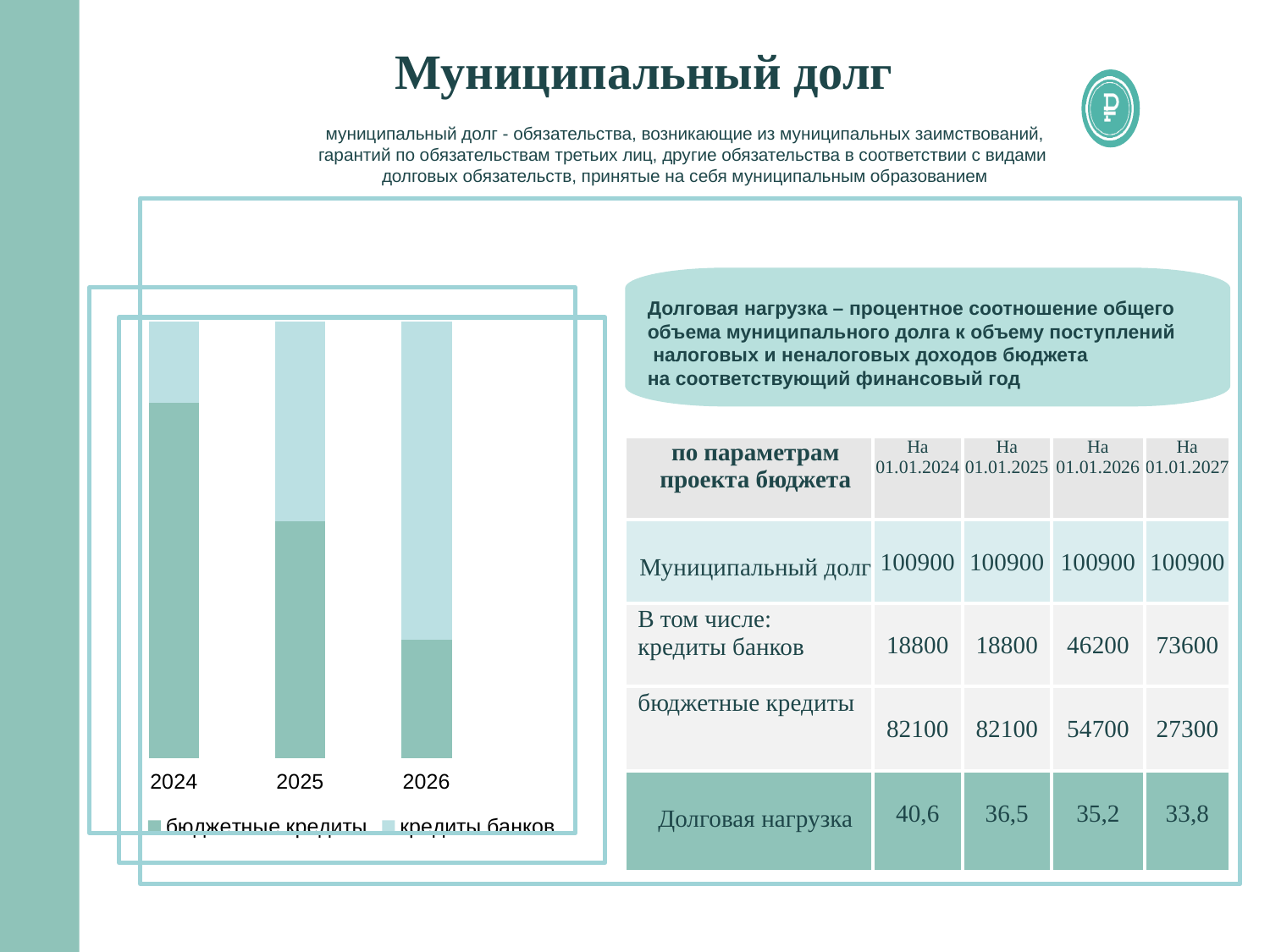
What kind of chart is shown on the left of the slide? bar chart In the 2024 bar, which segment is larger: бюджетные кредиты or кредиты банков? бюджетные кредиты Does the кредиты банков segment rise or fall from 2024 to 2026 in the bar chart? rise In the 2026 bar, which segment is larger: бюджетные кредиты or кредиты банков? кредиты банков How many series does the legend of the bar chart list? 2 In which year is the кредиты банков segment the largest in the bar chart? 2026 Does the бюджетные кредиты segment rise or fall from 2024 to 2026 in the bar chart? fall What are the two series named in the legend of the bar chart? бюджетные кредиты, кредиты банков How many years are shown on the x axis of the bar chart? 3 In which year is the бюджетные кредиты segment the smallest in the bar chart? 2026 In which year is the бюджетные кредиты segment the largest in the bar chart? 2024 Which series is shown in the darker green colour in the bar chart? бюджетные кредиты